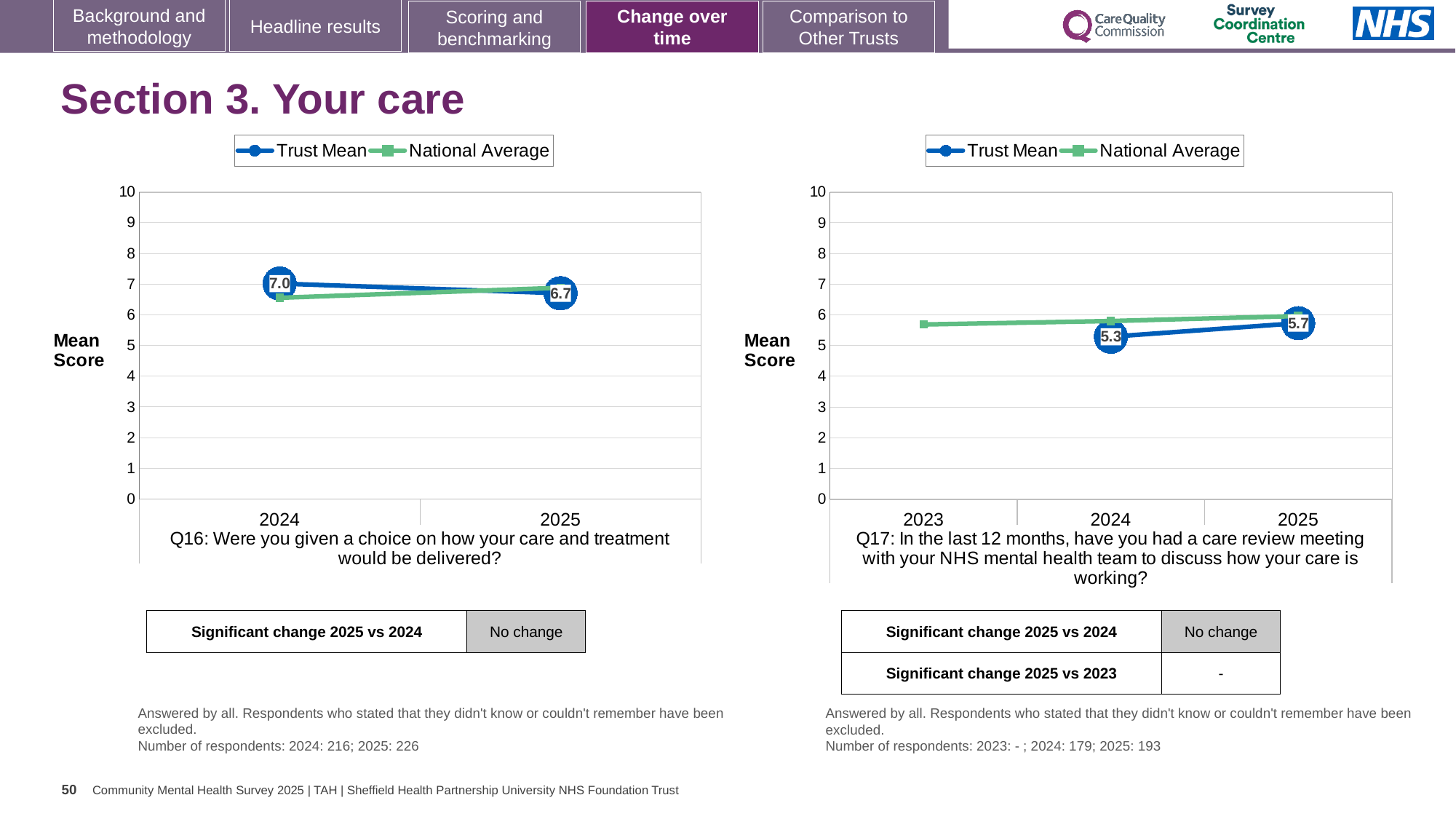
In the right chart (Q17), does the Trust Mean rise or fall from 2024 to 2025? rise What kind of chart is the left chart (Q16)? line chart In the left chart (Q16), by how much did the Trust Mean change from 2024 to 2025? 0.3 In the right chart (Q17), what is the Trust Mean for 2025? 5.7 How many years are shown on the x axis of the right chart (Q17)? 3 In the right chart (Q17), what is the Trust Mean for 2024? 5.3 In the right chart (Q17), what is the difference between the Trust Mean in 2025 and in 2024? 0.4 In the left chart (Q16), does the Trust Mean rise or fall from 2024 to 2025? fall In the left chart (Q16), what is the Trust Mean for 2025? 6.7 How many series does the legend of the right chart (Q17) list? 2 In the left chart (Q16), is the National Average for 2024 greater or less than 7? less In the left chart (Q16), what is the Trust Mean for 2024? 7.0